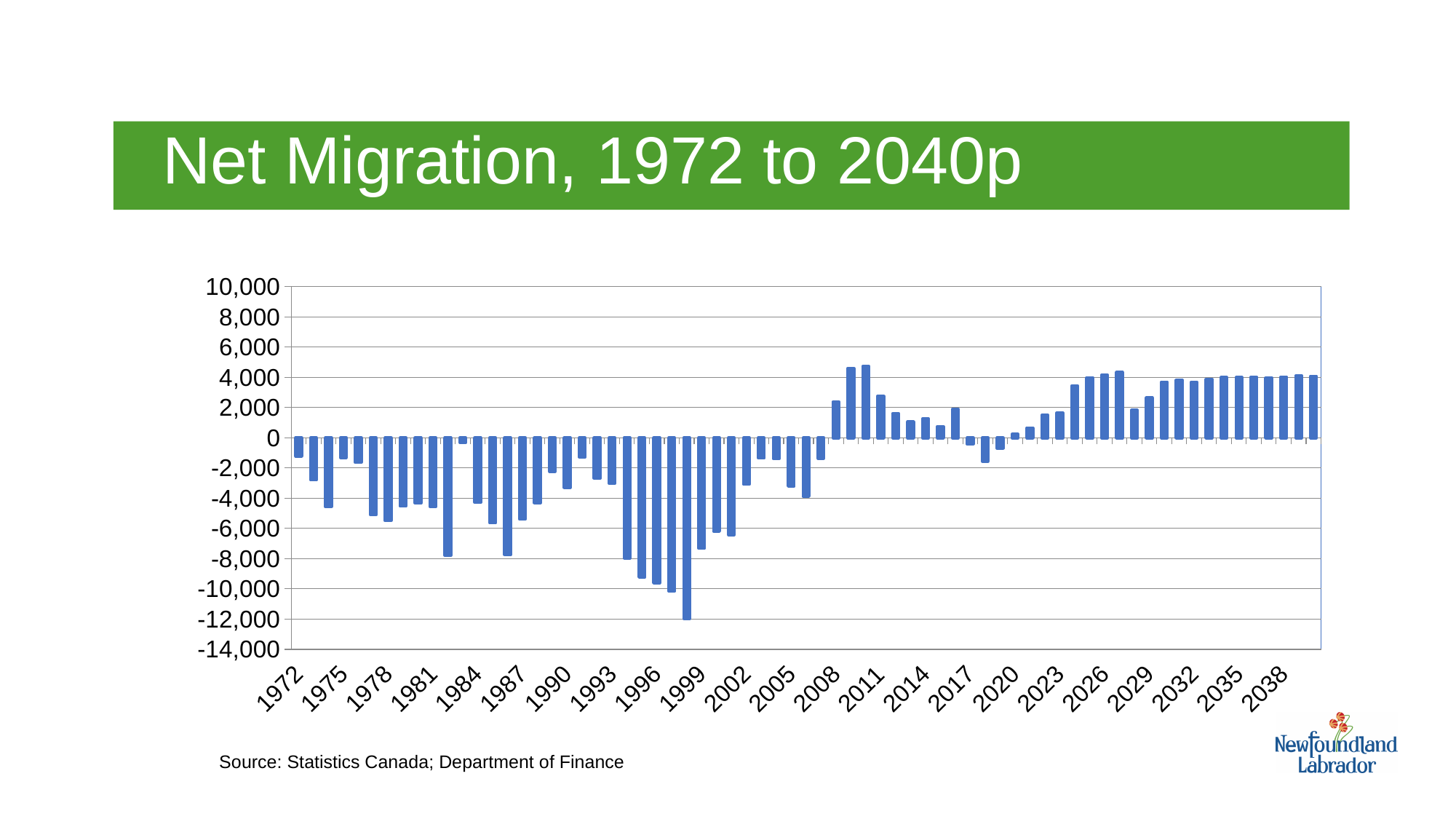
What kind of chart is shown on the slide? bar chart Is the value for 1978 greater or less than -4,000? less Is the value for 1996 greater or less than -8,000? less Is the value for 2011 greater or less than 2,000? greater Which year has the higher net migration, 1996 or 1999? 1999 Do the values generally rise or fall between 2020 and 2027? rise What is the title of the chart? Net Migration, 1972 to 2040p What source is cited below the chart? Statistics Canada; Department of Finance